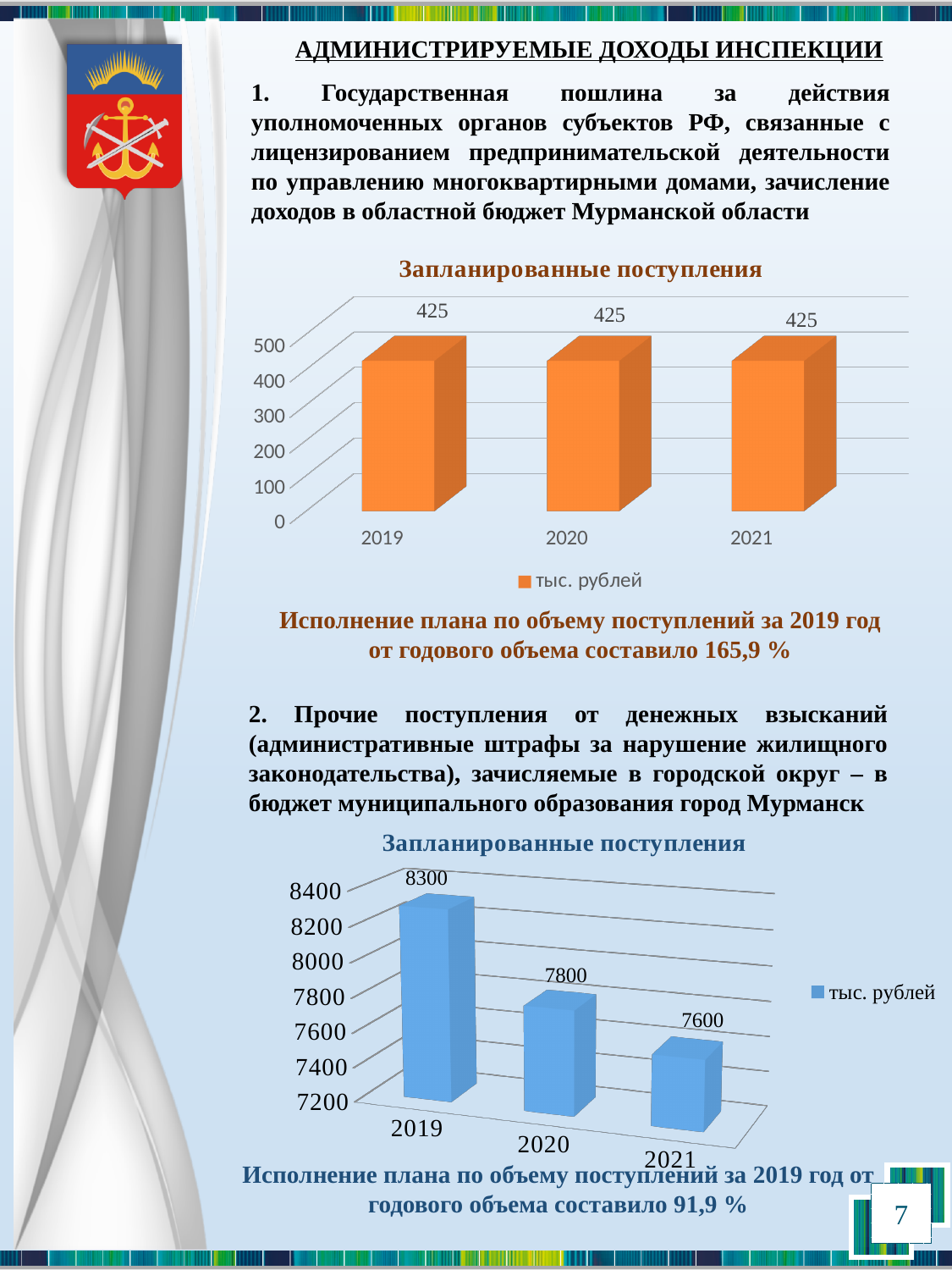
In the bottom chart, do the values rise or fall from 2019 to 2021? fall In the bottom chart, which is larger, the value for 2020 or the value for 2021? 2020 How many years are shown in the top chart? 3 In the top chart, what is the value for 2019? 425 In the bottom chart, what is the value for 2019? 8300 What type of chart is the top chart? bar chart In the top chart, what is the value for 2021? 425 In the bottom chart, what is the difference between the values for 2019 and 2021? 700 In the bottom chart, which year has the lowest value? 2021 In the bottom chart, what is the value for 2021? 7600 In the bottom chart, which year has the highest value? 2019 In the bottom chart, what is the value for 2020? 7800